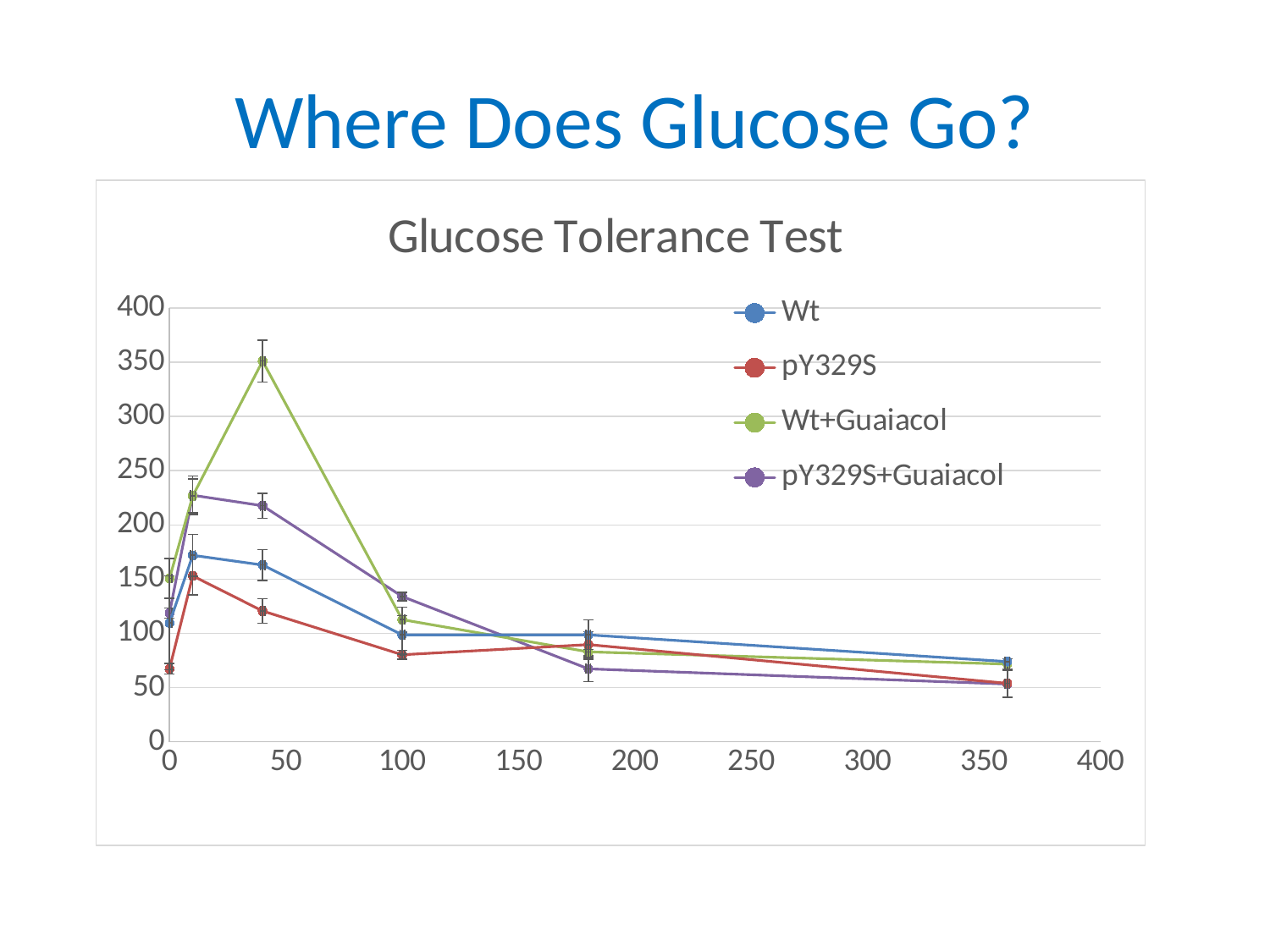
Is the value for pY329S+Guaiacol at x = 10 greater or less than 200? greater How many series does the legend list? 4 What is the title of the chart? Glucose Tolerance Test What kind of chart is shown on the slide? line chart Which series reaches the highest value on the chart? Wt+Guaiacol Is the value for Wt at x = 360 greater or less than 100? less Is the value for pY329S at x = 100 greater or less than 100? less At x = 100, which series has the larger value, pY329S or pY329S+Guaiacol? pY329S+Guaiacol Which series has the lowest peak value? pY329S At x = 40, which series has the larger value, Wt or Wt+Guaiacol? Wt+Guaiacol Does the Wt+Guaiacol series rise or fall between x = 40 and x = 360? fall